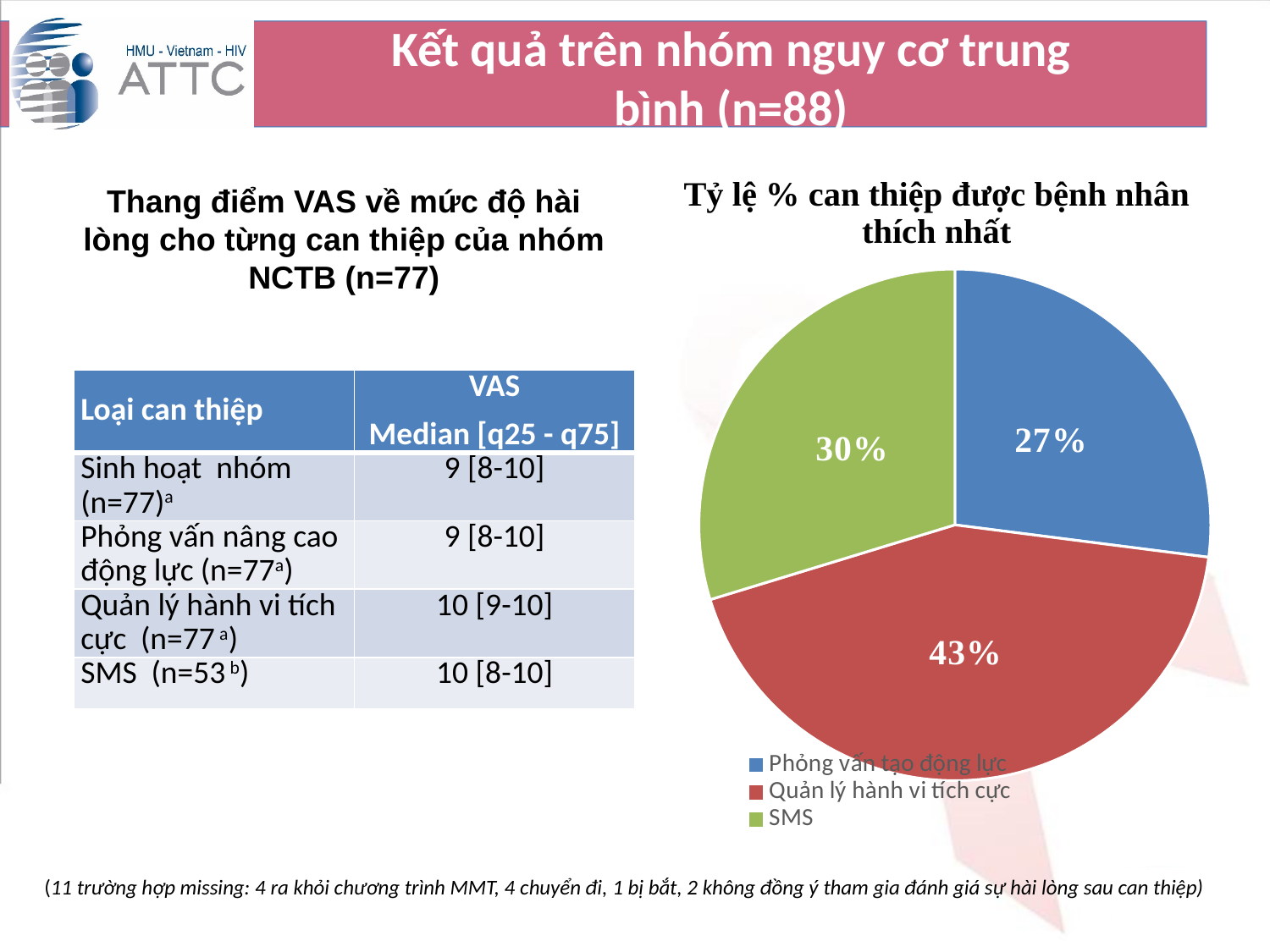
What is the title of the pie chart? Tỷ lệ % can thiệp được bệnh nhân thích nhất Which category has the smallest slice in the pie chart? Phỏng vấn tạo động lực In the pie chart, which is larger: the slice for SMS or the slice for Phỏng vấn tạo động lực? SMS Which category has the largest slice in the pie chart? Quản lý hành vi tích cực How many entries does the legend of the pie chart list? 3 In the pie chart, what percentage is shown for Phỏng vấn tạo động lực? 27% How many slices does the pie chart have? 3 In the pie chart, what percentage is shown for SMS? 30% What kind of chart is shown on the slide? pie chart In the pie chart, which colour represents SMS? green In the pie chart, what percentage is shown for Quản lý hành vi tích cực? 43% In the pie chart, what is the difference in percentage points between Quản lý hành vi tích cực and SMS? 13